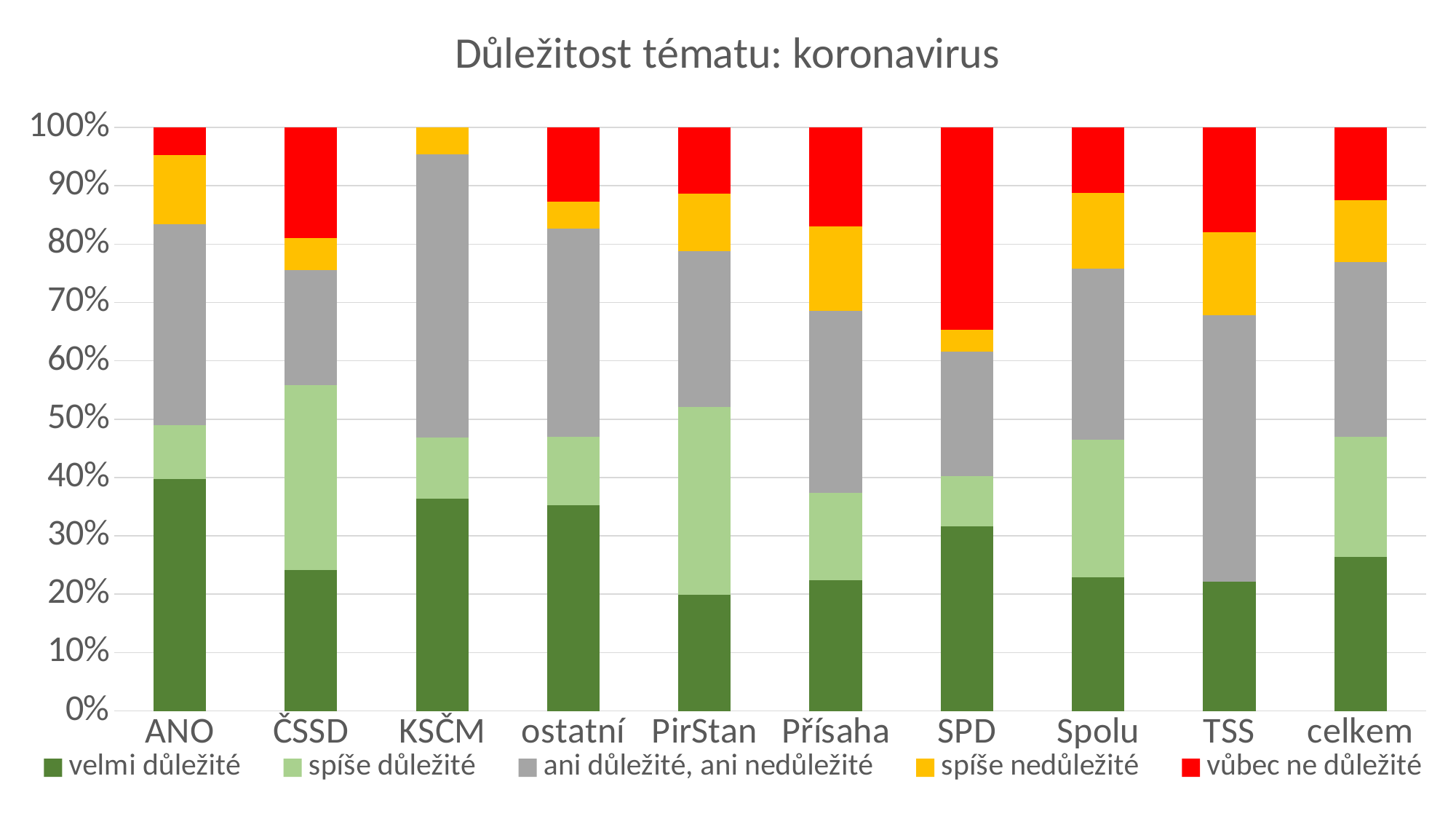
Is the 'velmi důležité' share for ANO greater or less than 30%? greater Is the 'velmi důležité' share for PirStan greater or less than 30%? less Which category has the smallest 'velmi důležité' share? PirStan Which category has the largest 'vůbec ne důležité' share? SPD How many categories are shown on the x axis? 10 Which category has the largest 'velmi důležité' share? ANO How many series does the legend list? 5 What is the title of the chart? Důležitost tématu: koronavirus Which has a larger 'vůbec ne důležité' share, SPD or ANO? SPD What kind of chart is shown on the slide? stacked bar chart Which category shows no 'vůbec ne důležité' segment at all? KSČM Which has a larger 'spíše důležité' share, ČSSD or SPD? ČSSD